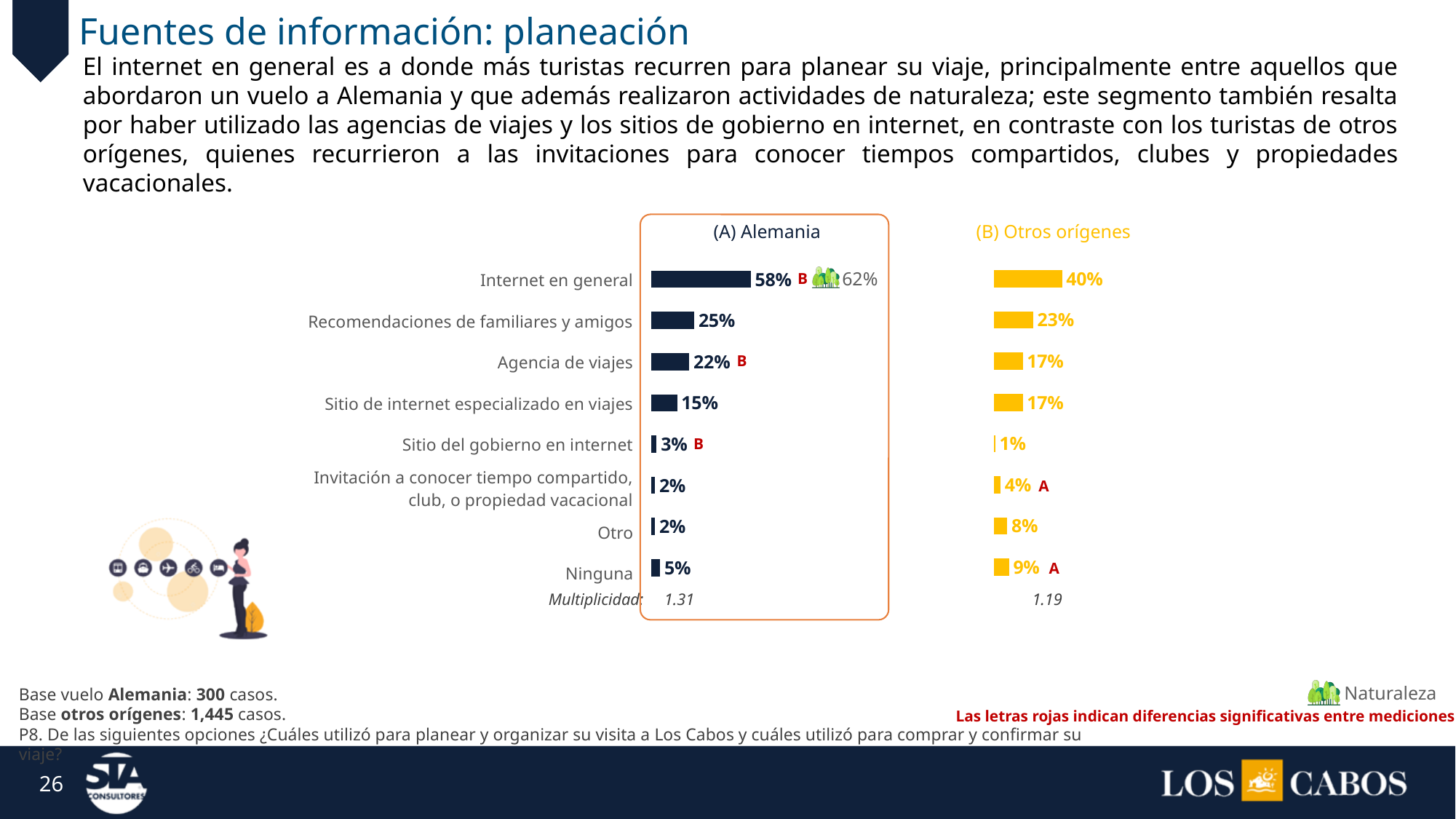
In the (B) Otros orígenes chart, what is the value for Otro? 8% In the (A) Alemania chart, which category has the highest value? Internet en general In the (A) Alemania chart, what is the value for Internet en general? 58% What is the difference between the Internet en general values in the (A) Alemania chart and the (B) Otros orígenes chart? 18 percentage points What kind of chart is the (B) Otros orígenes chart? Bar chart In the (B) Otros orígenes chart, which category has the lowest value? Sitio del gobierno en internet How many categories are shown in the (A) Alemania chart? 8 In the (A) Alemania chart, what is the difference between Recomendaciones de familiares y amigos and Sitio de internet especializado en viajes? 10 percentage points In the (A) Alemania chart, what is the value for Agencia de viajes? 22% What is the Multiplicidad value shown under the (B) Otros orígenes chart? 1.19 Which is larger: Ninguna in the (A) Alemania chart or Ninguna in the (B) Otros orígenes chart? (B) Otros orígenes In the (B) Otros orígenes chart, what is the value for Recomendaciones de familiares y amigos? 23%